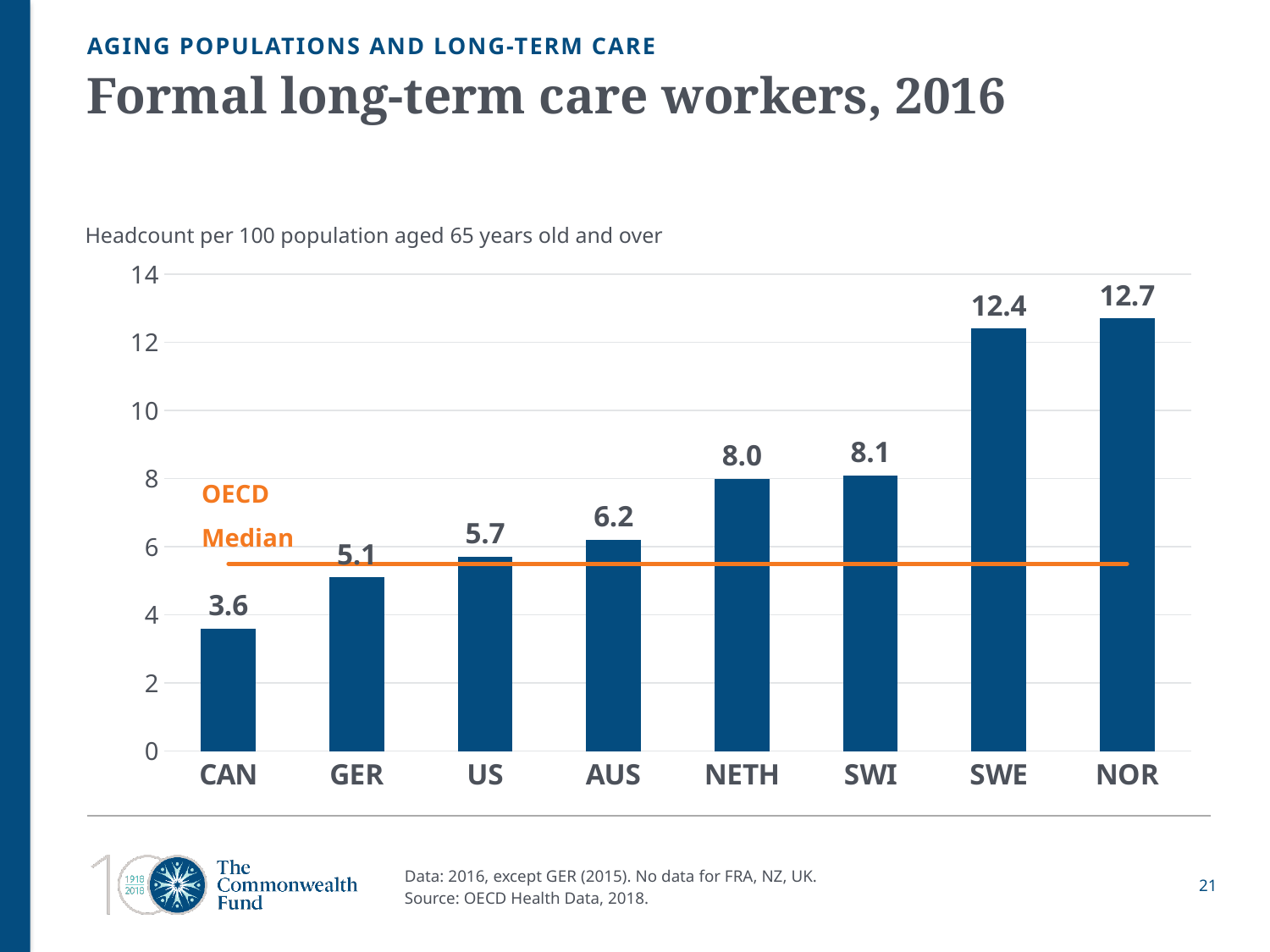
What is the difference between the values for NOR and CAN? 9.1 What is the value for NETH? 8.0 Which is larger, the value for GER or the value for AUS? AUS Which country has the highest value? NOR What does the orange horizontal line on the chart represent? OECD Median How many countries are shown on the chart? 8 Which country has the lowest value? CAN What is the value for CAN? 3.6 What kind of chart is shown on the slide? bar chart What is the value for SWE? 12.4 Is the value for SWI greater or less than 6? greater What is the difference between the values for AUS and US? 0.5